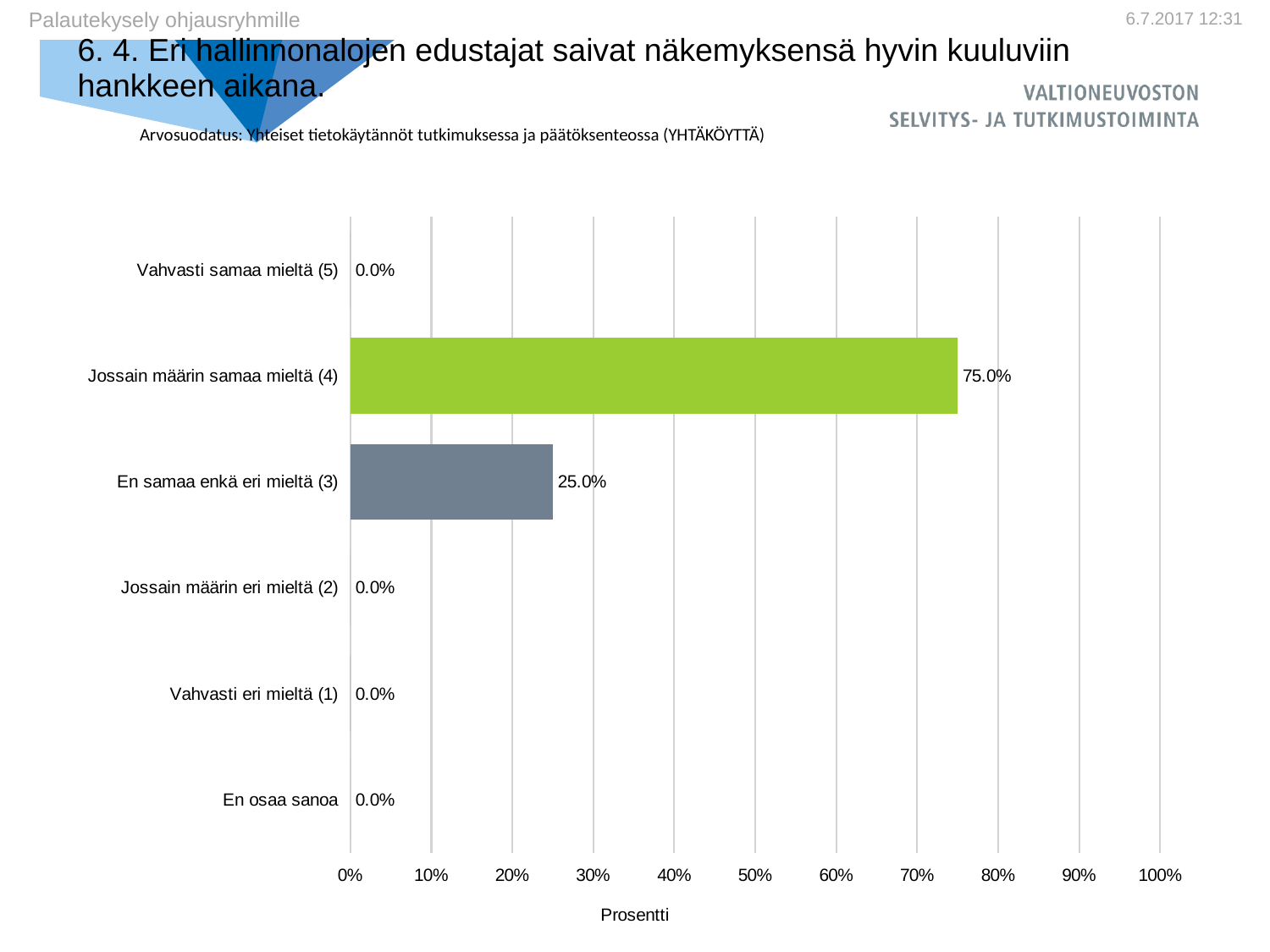
What is the value for "En osaa sanoa"? 0.0% What is the value for "En samaa enkä eri mieltä (3)"? 25.0% What is the value for "Jossain määrin samaa mieltä (4)"? 75.0% What is the label of the horizontal axis? Prosentti How many categories are shown on the chart? 6 Which is larger, the value for "En samaa enkä eri mieltä (3)" or the value for "Jossain määrin eri mieltä (2)"? En samaa enkä eri mieltä (3) Is the value for "Jossain määrin samaa mieltä (4)" greater or less than 50%? greater How many categories have a value of 0.0%? 4 Which category has the highest value? Jossain määrin samaa mieltä (4) What kind of chart is shown on the slide? bar chart What is the value for "Vahvasti samaa mieltä (5)"? 0.0% What is the difference between the values for "Jossain määrin samaa mieltä (4)" and "En samaa enkä eri mieltä (3)"? 50.0%